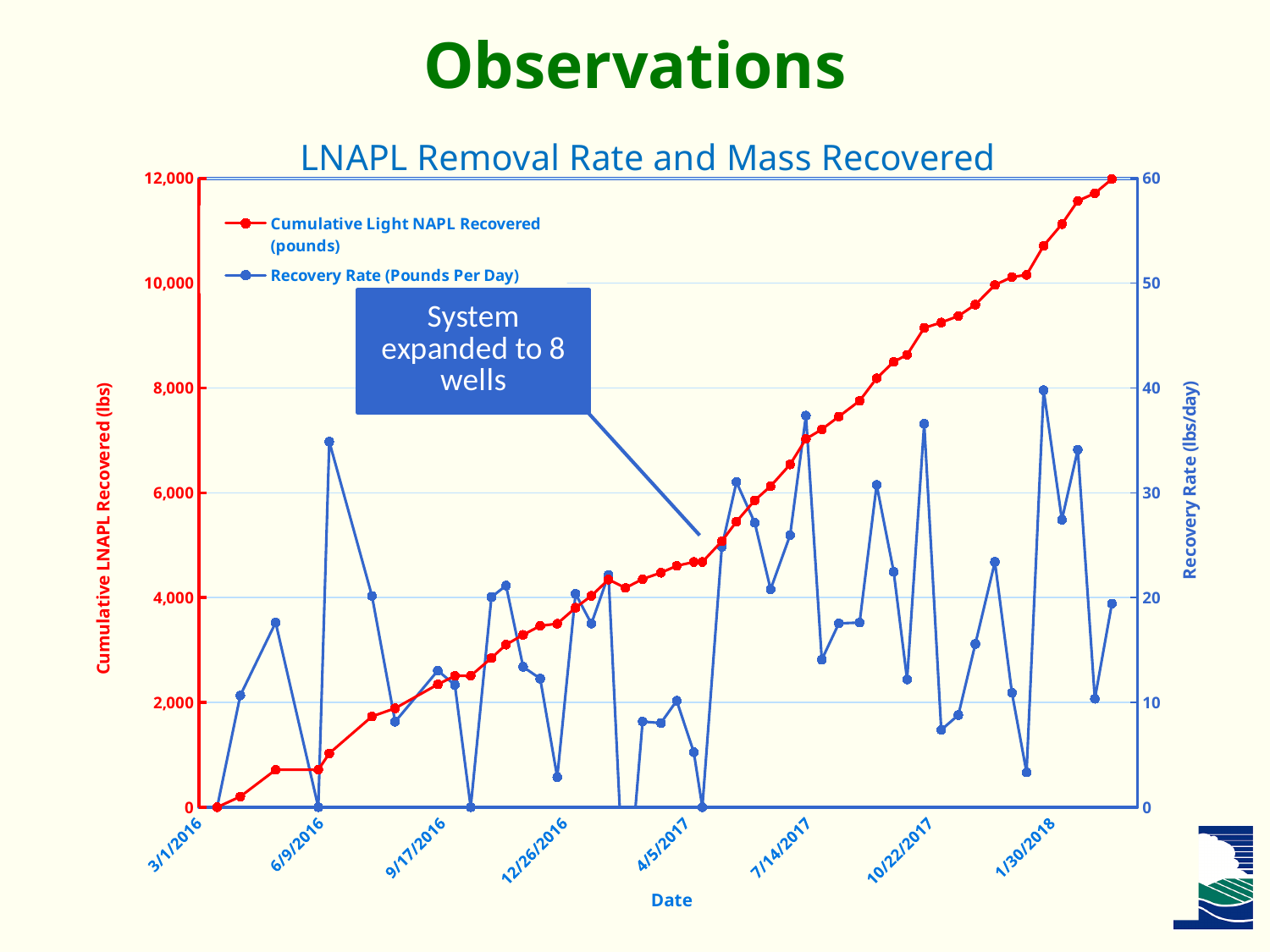
Which is larger, the Cumulative Light NAPL Recovered value at 10/22/2017 or at 4/5/2017? 10/22/2017 How many date labels are shown on the x axis? 8 Is the highest Recovery Rate (Pounds Per Day) value on the chart greater or less than 30? greater Is the Cumulative Light NAPL Recovered value at 4/5/2017 greater or less than 6,000? less Is the Cumulative Light NAPL Recovered value at 6/9/2016 greater or less than 2,000? less How many series does the legend list? 2 Does the Cumulative Light NAPL Recovered (pounds) series rise or fall along the x axis? rise What does the annotation box on the chart say? System expanded to 8 wells What is the title of the chart? LNAPL Removal Rate and Mass Recovered What kind of chart is shown on the slide? line chart